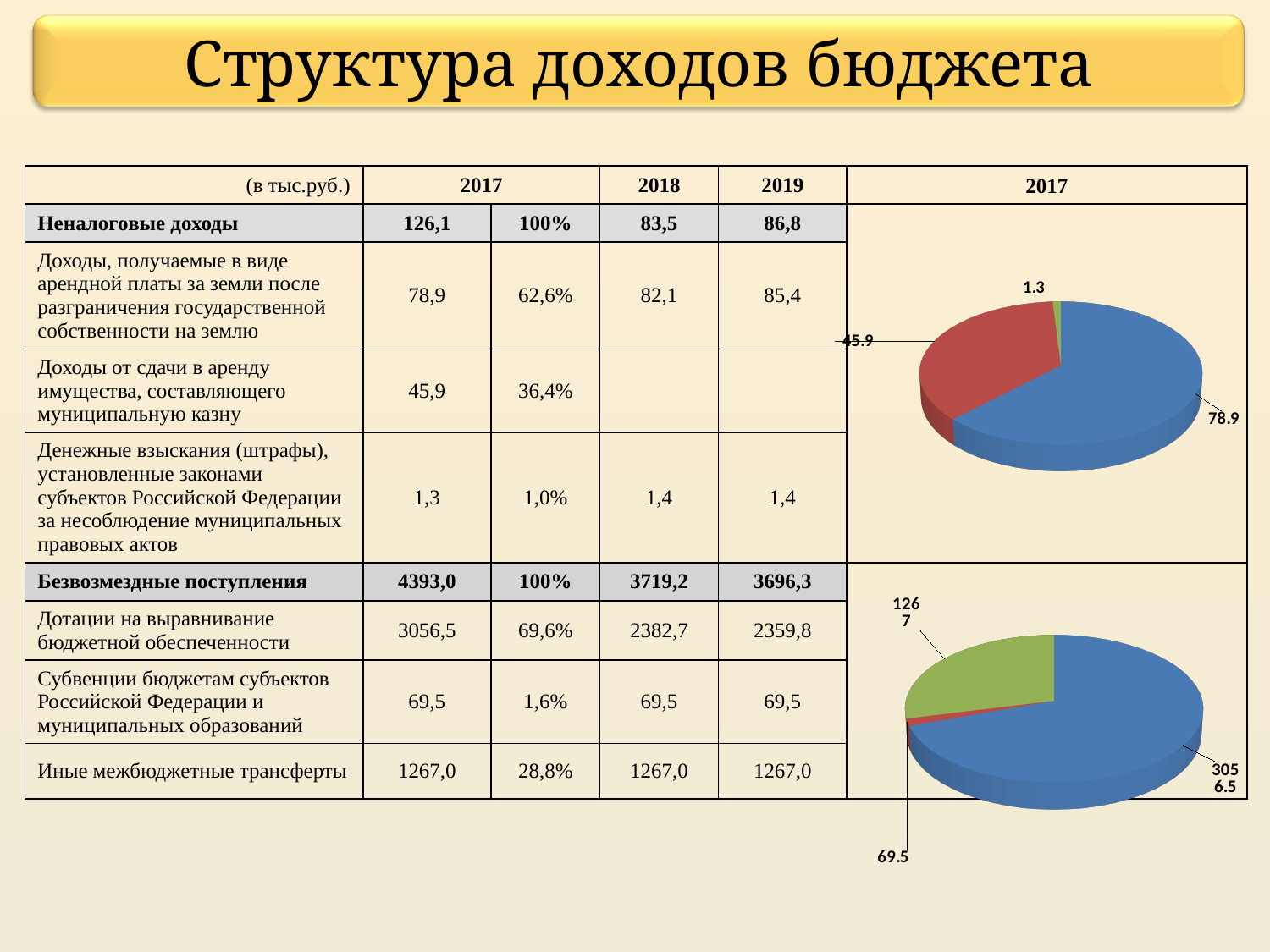
In the top pie chart, what colour is the largest slice? blue What is the total of all slice values in the bottom pie chart? 4393 What is the total of all slice values in the top pie chart? 126.1 How many slices does the bottom pie chart have? 3 How many pie charts are shown on the slide? 2 In the bottom pie chart, what is the value of the smallest slice? 69.5 What kind of chart is the top chart on the right side of the slide? pie chart In the bottom pie chart, what is the value of the largest slice? 3056.5 In the top pie chart, what is the difference between the 78.9 slice and the 45.9 slice? 33 In the top pie chart, what is the value of the smallest slice? 1.3 How many slices does the top pie chart have? 3 In the top pie chart, what is the value of the largest slice? 78.9